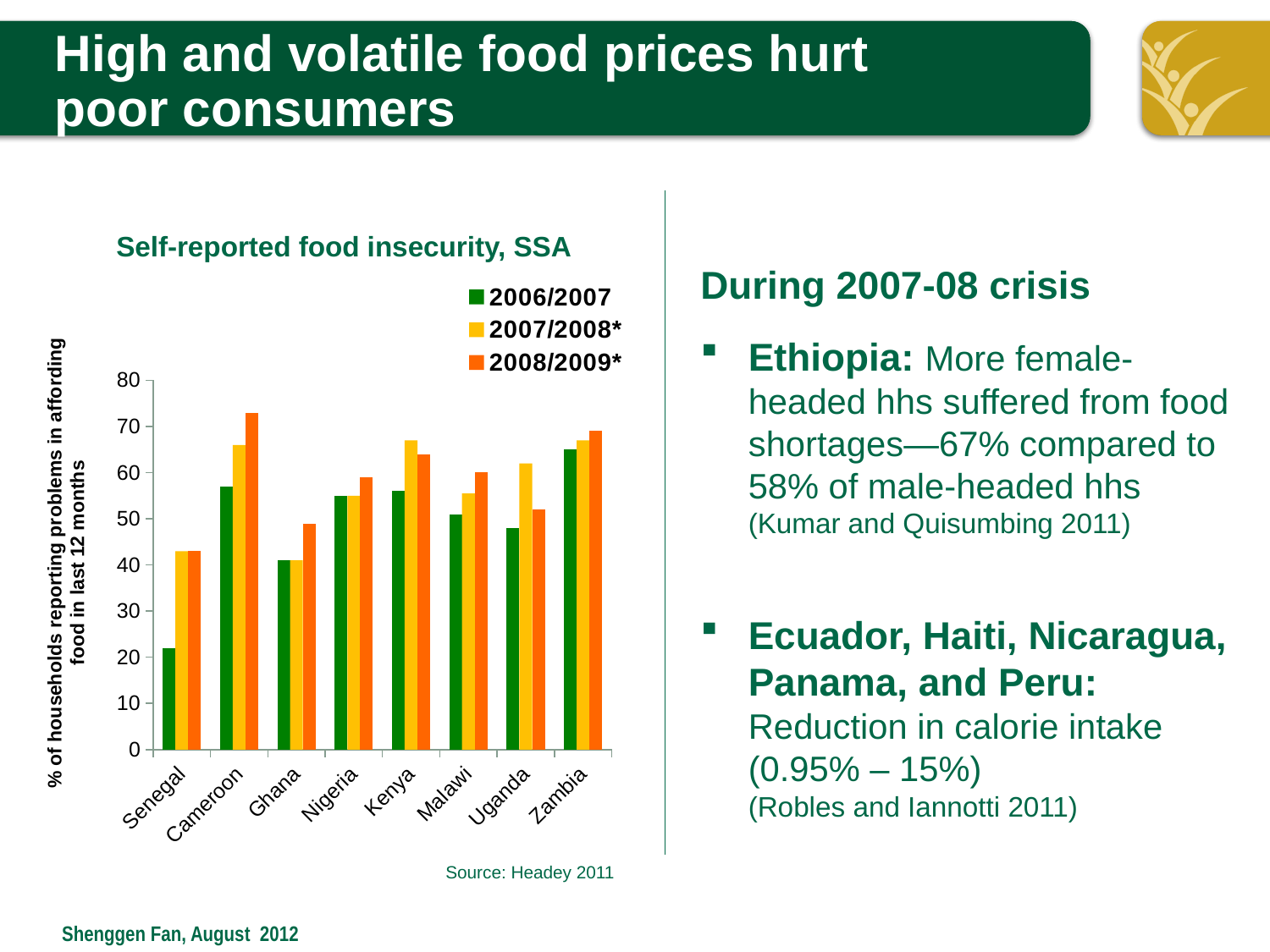
Do the values for Cameroon rise or fall from 2006/2007 to 2008/2009*? rise For Uganda, which is larger: the 2007/2008* value or the 2008/2009* value? 2007/2008* Is the value for Kenya in 2007/2008* greater or less than 60? greater What kind of chart is shown under the title "Self-reported food insecurity, SSA"? bar chart How many series does the chart's legend list? 3 Which country has the highest value for 2008/2009*? Cameroon Which country has the lowest value for 2006/2007? Senegal What is the label on the chart's vertical axis? % of households reporting problems in affording food in last 12 months How many countries are shown on the x axis of the chart? 8 Which country has the highest value for 2006/2007? Zambia Is the value for Senegal in 2006/2007 greater or less than 30? less Is the value for Cameroon in 2008/2009* greater or less than 70? greater